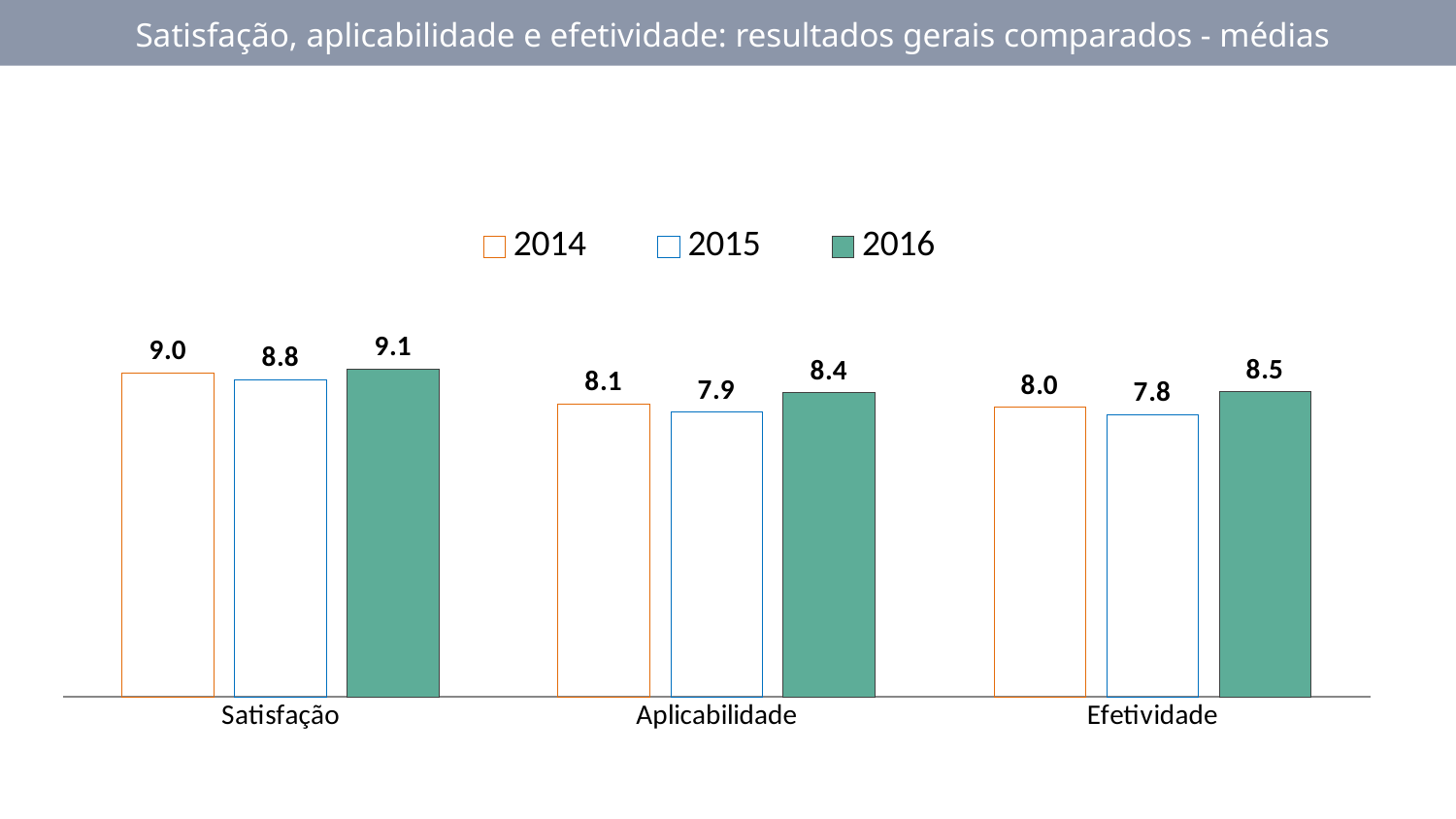
What is the difference between the 2014 and 2015 values for Satisfação? 0.2 What is the difference between the 2016 and 2015 values for Efetividade? 0.7 Which category has the highest value in 2016? Satisfação How many series does the legend list? 3 Which year is shown with solid green bars in the legend? 2016 What kind of chart is shown on the slide? Bar chart Which category has the lowest value in 2015? Efetividade How many categories are shown on the x axis? 3 What is the value for Aplicabilidade in 2015? 7.9 What is the value for Satisfação in 2016? 9.1 What is the value for Efetividade in 2014? 8.0 Which is larger for Aplicabilidade: the 2014 value or the 2016 value? 2016